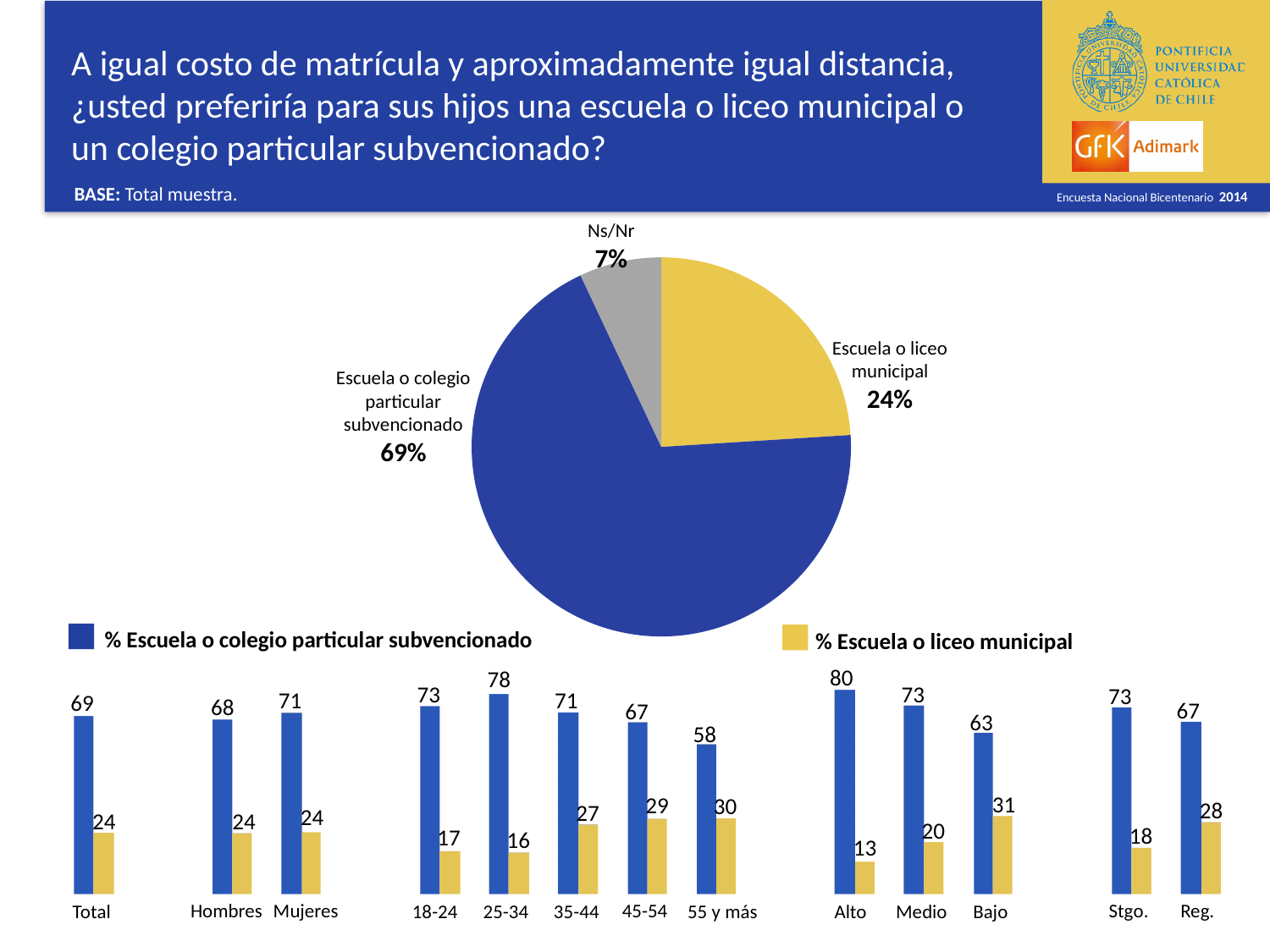
In the bar chart at the bottom, how many series does the legend list? 2 In the bar chart at the bottom, what is the difference between the '% Escuela o colegio particular subvencionado' values for Alto and Bajo? 17 In the bar chart at the bottom, which category has the lowest value for '% Escuela o colegio particular subvencionado'? 55 y más In the pie chart, what percentage is shown for 'Ns/Nr'? 7% In the pie chart, what share of respondents chose 'Escuela o colegio particular subvencionado'? 69% In the pie chart, how many slices are there? 3 In the bar chart at the bottom, what is the value of '% Escuela o colegio particular subvencionado' for 25-34? 78 In the pie chart, which slice is the smallest? Ns/Nr What type of chart is shown at the bottom of the slide? Bar chart In the bar chart at the bottom, what is the value of '% Escuela o liceo municipal' for Alto? 13 In the bar chart at the bottom, is the '% Escuela o liceo municipal' value higher for Stgo. or for Reg.? Reg. In the bar chart at the bottom, which category has the highest value for '% Escuela o colegio particular subvencionado'? Alto